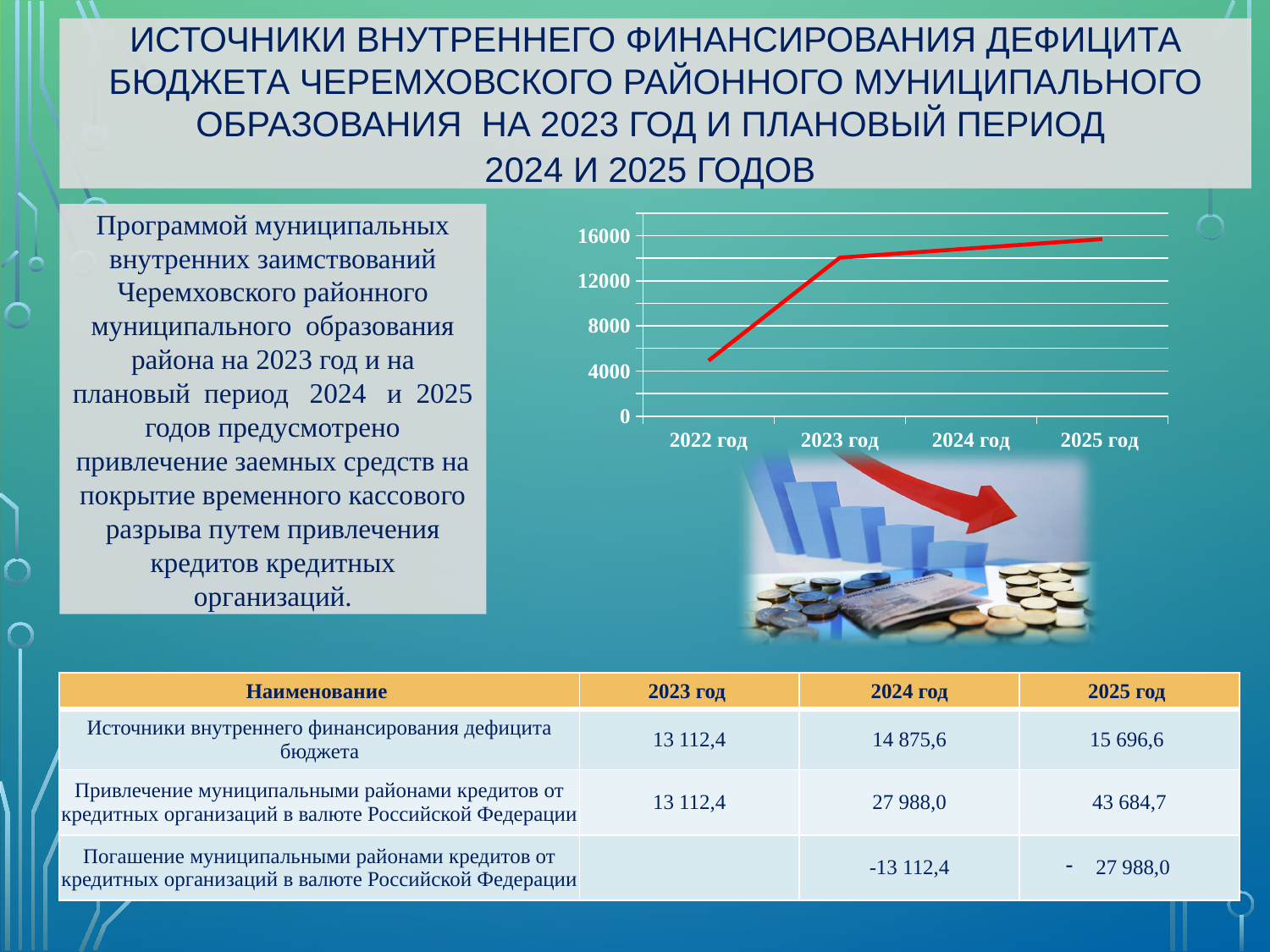
What is the highest tick value shown on the chart's vertical axis? 16000 Do the values on the chart rise or fall from 2022 год to 2025 год? rise Which year has the highest value on the chart? 2025 год Which year has the lowest value on the chart? 2022 год What colour is the line plotted on the chart? red How many years are plotted along the x axis of the chart? 4 Is the value for 2023 год greater or less than 12000? greater What kind of chart is shown on the slide? line chart Is the value for 2022 год greater or less than 8000? less Which is larger on the chart, the value for 2022 год or the value for 2023 год? 2023 год Is the value for 2022 год greater or less than 4000? greater